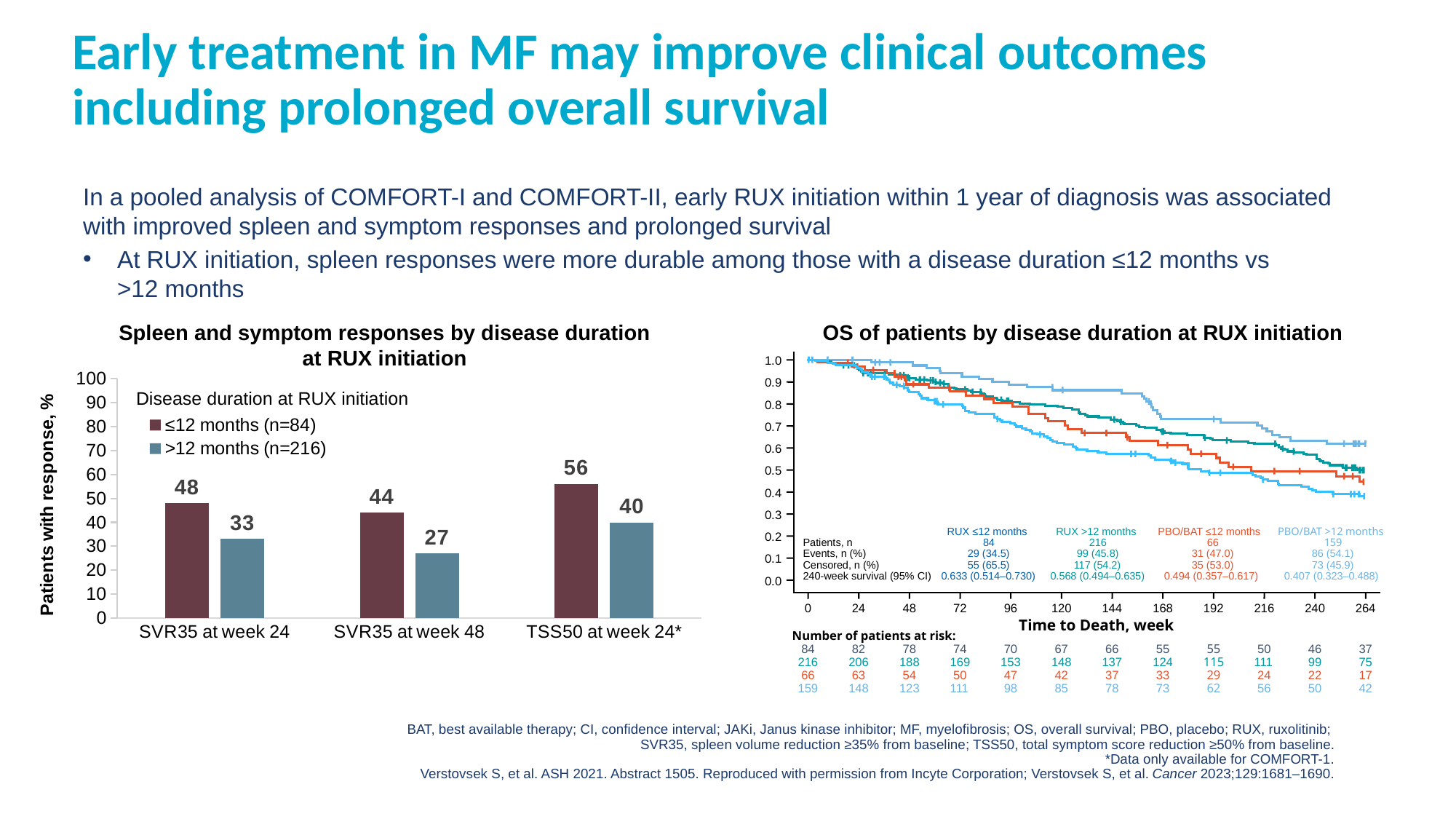
In the 'OS of patients by disease duration at RUX initiation' chart, how many RUX >12 months patients were at risk at week 120? 148 How many series does the legend of the 'Spleen and symptom responses by disease duration at RUX initiation' chart list? 2 How many categories are shown on the x axis of the 'Spleen and symptom responses by disease duration at RUX initiation' chart? 3 In the 'Spleen and symptom responses by disease duration at RUX initiation' chart, which category has the lowest value for the >12 months series? SVR35 at week 48 In the 'Spleen and symptom responses by disease duration at RUX initiation' chart, which series has the larger value at SVR35 at week 24? ≤12 months (n=84) In the 'Spleen and symptom responses by disease duration at RUX initiation' chart, what is the value for ≤12 months at SVR35 at week 24? 48 In the 'Spleen and symptom responses by disease duration at RUX initiation' chart, what is the difference between the ≤12 months and >12 months values at SVR35 at week 48? 17 In the 'OS of patients by disease duration at RUX initiation' chart, what is the 240-week survival for RUX ≤12 months? 0.633 (0.514–0.730) What kind of chart is the 'Spleen and symptom responses by disease duration at RUX initiation' chart? Bar chart In the 'Spleen and symptom responses by disease duration at RUX initiation' chart, which category has the highest value for the ≤12 months series? TSS50 at week 24* In the 'OS of patients by disease duration at RUX initiation' chart, do the survival curves rise or fall along the x axis? Fall In the 'Spleen and symptom responses by disease duration at RUX initiation' chart, what is the value for >12 months at TSS50 at week 24*? 40